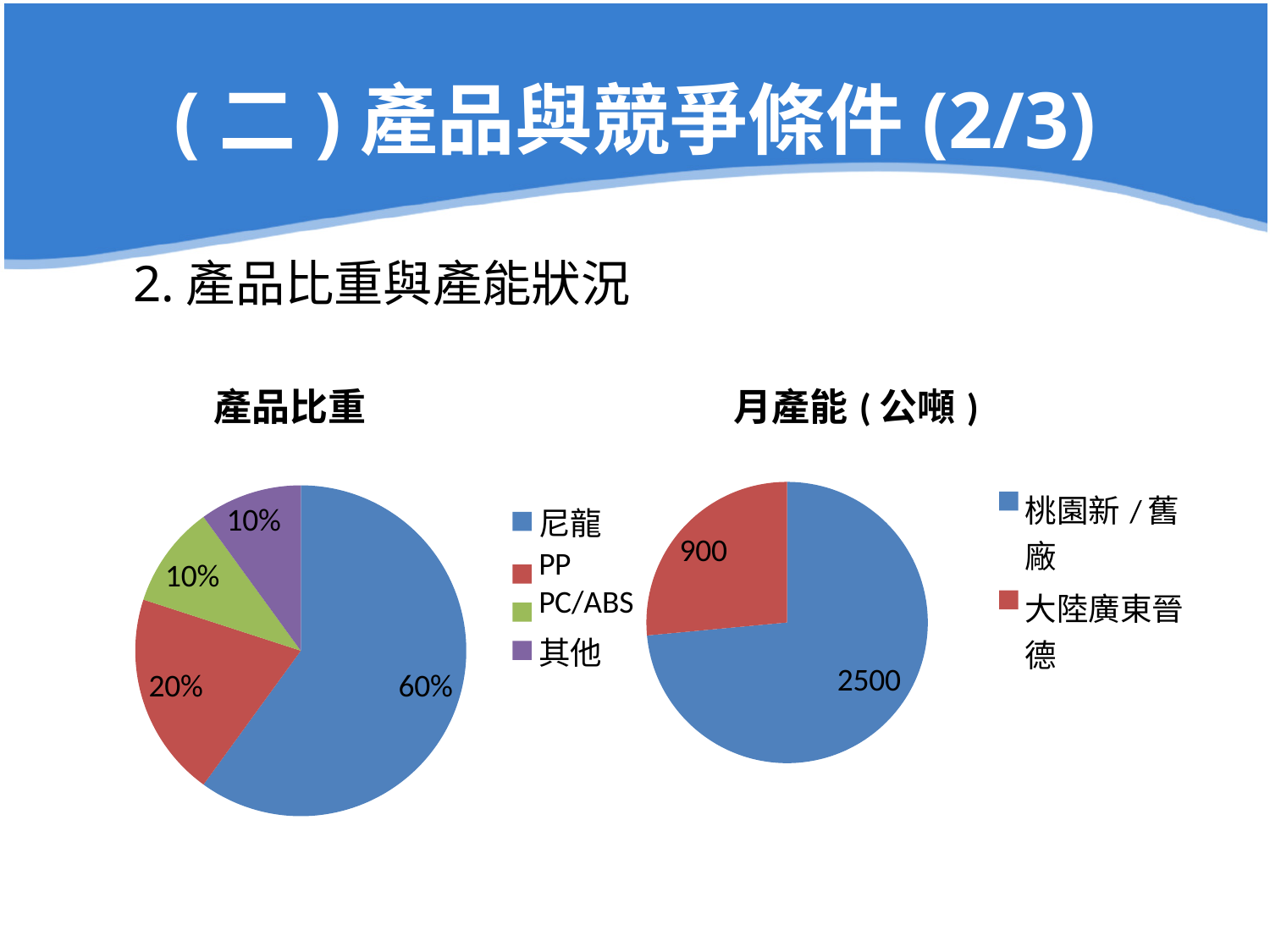
In the 產品比重 chart, what share does 尼龍 have? 60% In the 月產能(公噸) chart, what is the value for 桃園新/舊廠? 2500 In the 產品比重 chart, what is the difference between the shares of 尼龍 and PP? 40% In the 產品比重 chart, what share does PC/ABS have? 10% In the 產品比重 chart, what share does PP have? 20% In the 產品比重 chart, which category has the largest share? 尼龍 In the 月產能(公噸) chart, what colour is the slice for 大陸廣東晉德? Red In the 月產能(公噸) chart, what is the value for 大陸廣東晉德? 900 In the 月產能(公噸) chart, which category has the smaller value? 大陸廣東晉德 In the 產品比重 chart, how many categories does the legend list? 4 In the 月產能(公噸) chart, what is the difference between 桃園新/舊廠 and 大陸廣東晉德? 1600 What kind of chart is the 產品比重 chart? Pie chart